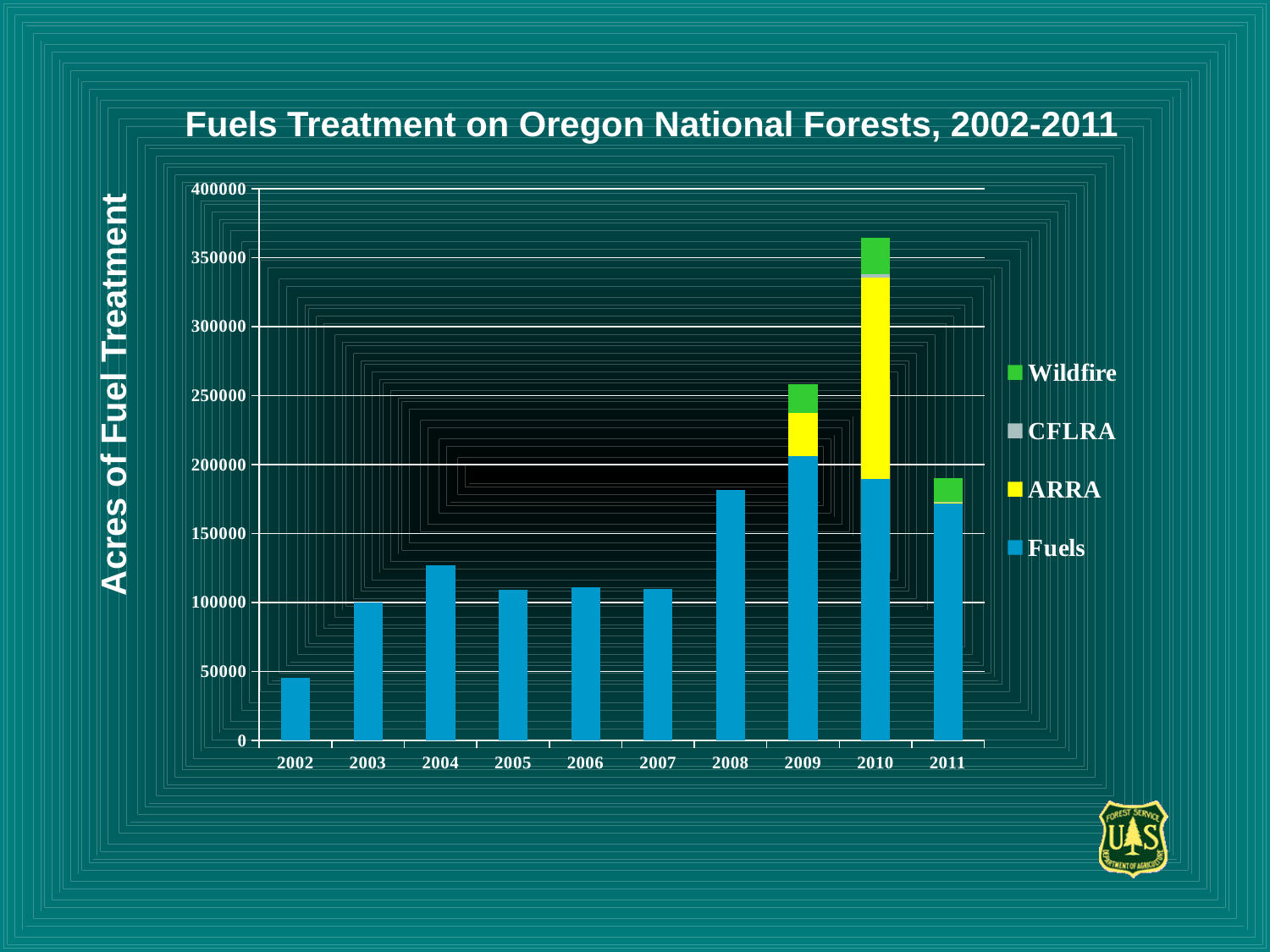
Which year has the shortest bar? 2002 What type of chart is shown on the slide? Stacked bar chart What is the label on the y axis of the chart? Acres of Fuel Treatment How many series does the legend list? 4 How many years are shown on the x axis of the chart? 10 Is the value for 2002 greater or less than 50000? less Which year has the tallest total bar? 2010 Which year has the larger bar, 2007 or 2008? 2008 Is the total value for 2010 greater or less than 350000? greater Is the total value for 2011 greater or less than 200000? less Do the bar values rise or fall from 2002 to 2004? rise